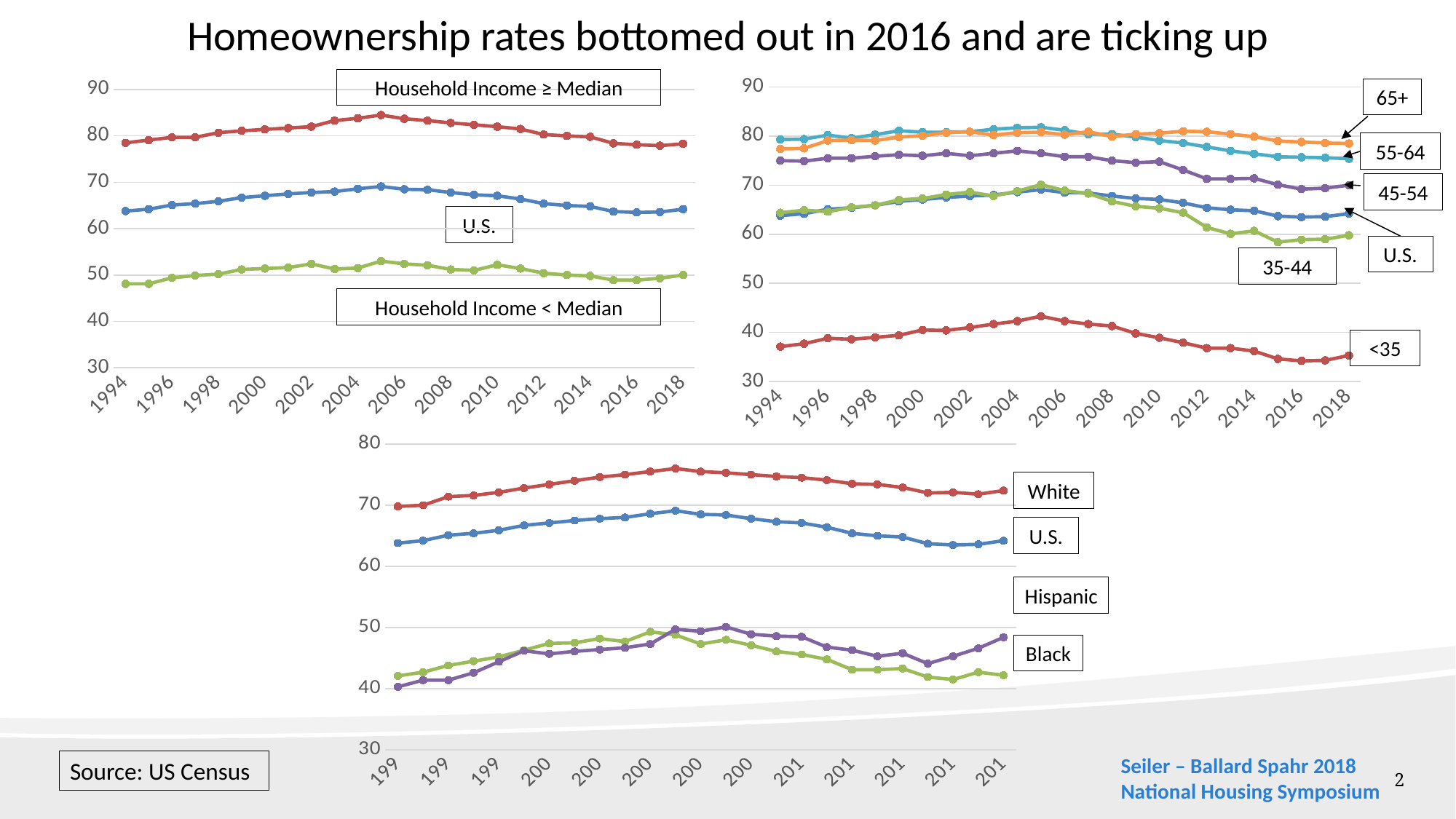
How many series are labelled on the bottom chart? 4 In the bottom chart, which is larger in 2018, the value for White or the value for Black? White In the top-left chart, is the 2018 value for Household Income ≥ Median greater or less than 70? greater In the top-right chart, which age group has the lowest homeownership rate in 2018? <35 In the top-right chart, is the 2018 value for the <35 group greater or less than 40? less What kind of chart is the top-left chart on the slide? line chart In the bottom chart, is the 2018 value for Black greater or less than 50? less In the top-left chart, does the Household Income ≥ Median line rise or fall from 2006 to 2016? fall What is the title of the slide? Homeownership rates bottomed out in 2016 and are ticking up In the top-right chart, which age group has the highest homeownership rate in 2018? 65+ How many series are labelled on the top-right chart? 6